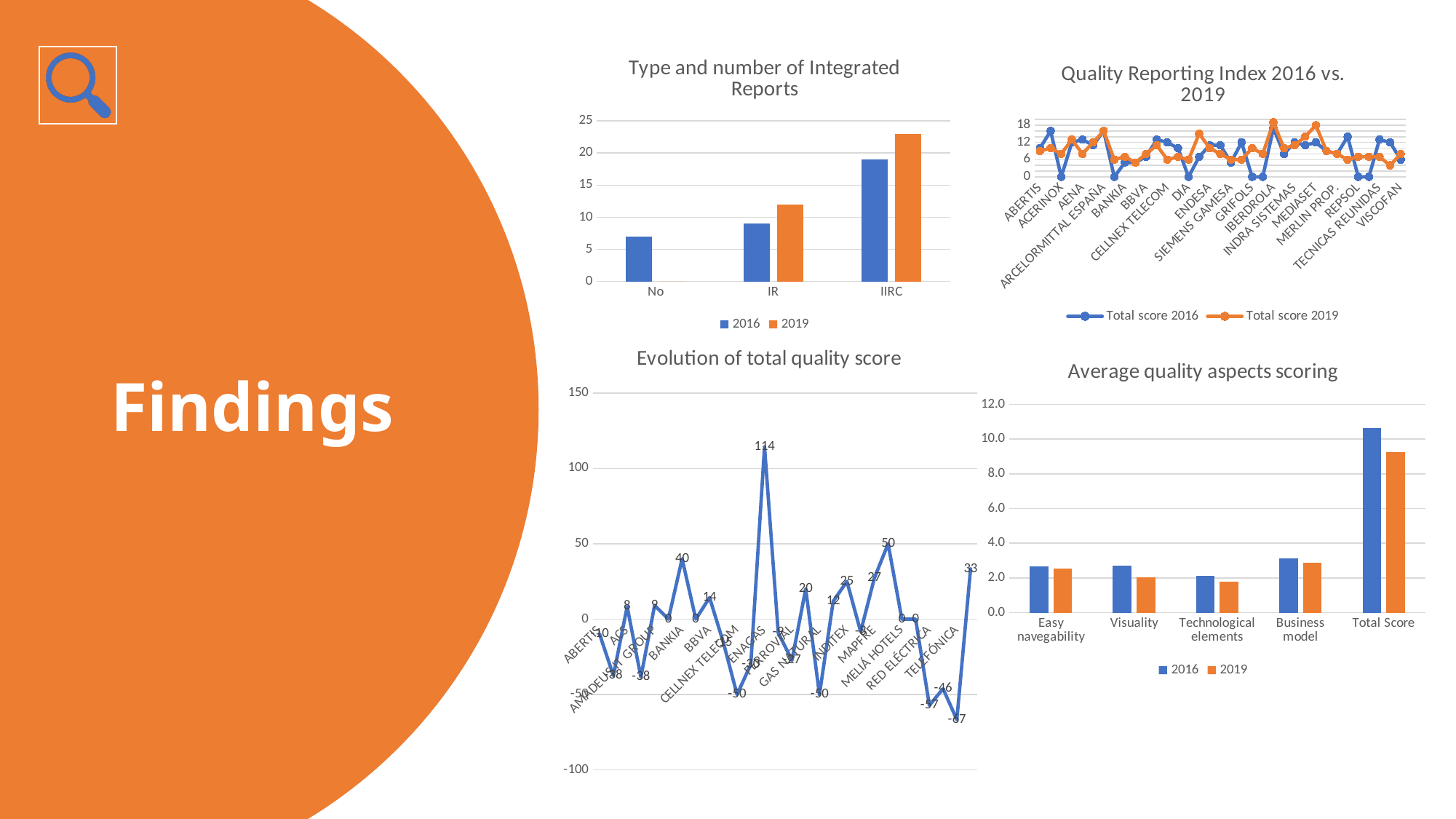
In the 'Evolution of total quality score' chart, what is the highest value labelled? 114 In the 'Evolution of total quality score' chart, what is the lowest value labelled? -67 In the 'Type and number of Integrated Reports' chart, which is larger for IR: the 2016 value or the 2019 value? 2019 How many series does the legend of the 'Quality Reporting Index 2016 vs. 2019' chart list? 2 In the 'Type and number of Integrated Reports' chart, is the 2016 value for No greater or less than 10? less In the 'Type and number of Integrated Reports' chart, is the 2019 value for IIRC greater or less than 20? greater In the 'Type and number of Integrated Reports' chart, how many categories are shown on the x axis? 3 In the 'Average quality aspects scoring' chart, is the 2016 value for Total Score greater or less than 10.0? greater In the 'Type and number of Integrated Reports' chart, which category has the highest 2016 value? IIRC In the 'Average quality aspects scoring' chart, which category has the highest values? Total Score What kind of chart is 'Evolution of total quality score'? line chart What kind of chart is 'Type and number of Integrated Reports'? bar chart